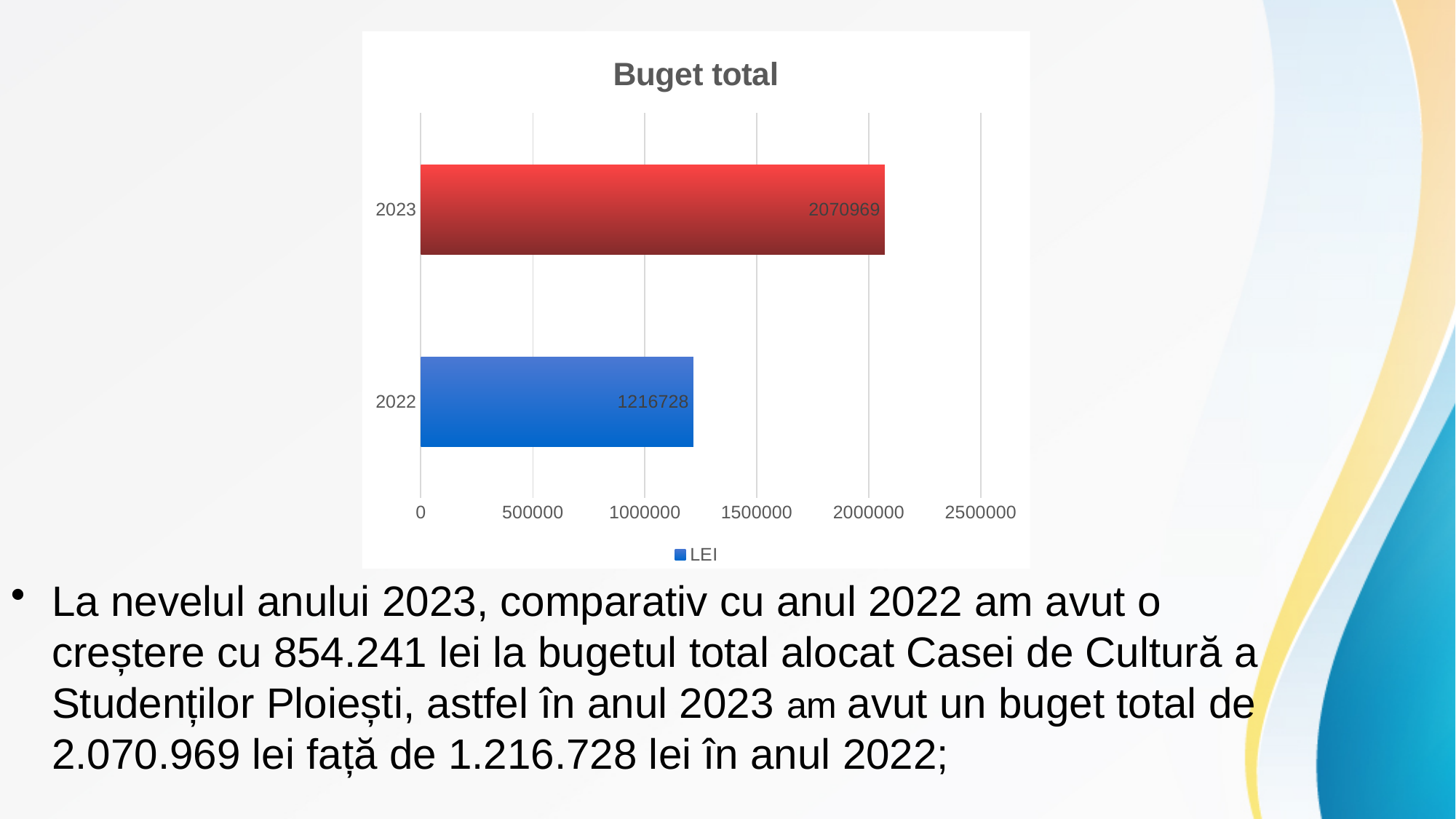
Is the value for 2022 in the Buget total chart greater or less than 1500000? less What kind of chart is the Buget total chart? bar chart Which year has the lowest value in the Buget total chart? 2022 What is the value for 2022 in the Buget total chart? 1216728 How many series does the legend of the Buget total chart list? 1 What is the value for 2023 in the Buget total chart? 2070969 Is the value for 2023 in the Buget total chart greater or less than 2000000? greater What is the difference between the 2023 and 2022 values in the Buget total chart? 854241 How many categories are shown in the Buget total chart? 2 What is the legend entry shown in the Buget total chart? LEI Which is larger in the Buget total chart, the value for 2022 or the value for 2023? 2023 Which year has the highest value in the Buget total chart? 2023